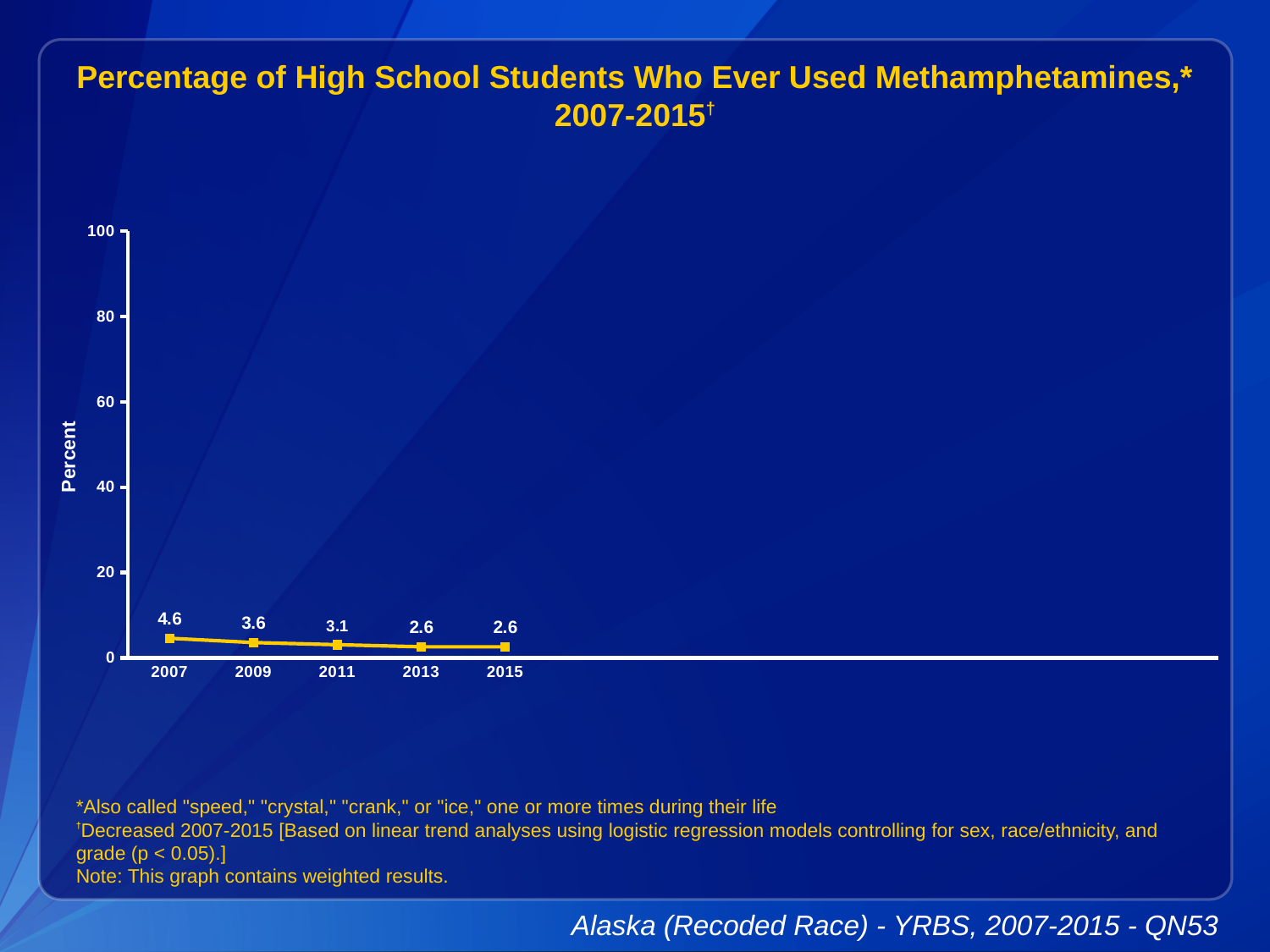
Do the values rise or fall from 2007 to 2015? fall How many years are plotted on the chart? 5 What is the value for 2011? 3.1 What is the difference between the values for 2007 and 2015? 2.0 What is the value for 2015? 2.6 What is the value for 2007? 4.6 What is the difference between the values for 2009 and 2011? 0.5 What kind of chart is shown? line chart What is the label on the y axis? Percent Which is larger, the value for 2009 or the value for 2013? 2009 Is the value for 2007 greater or less than 20? less Which year has the highest value? 2007